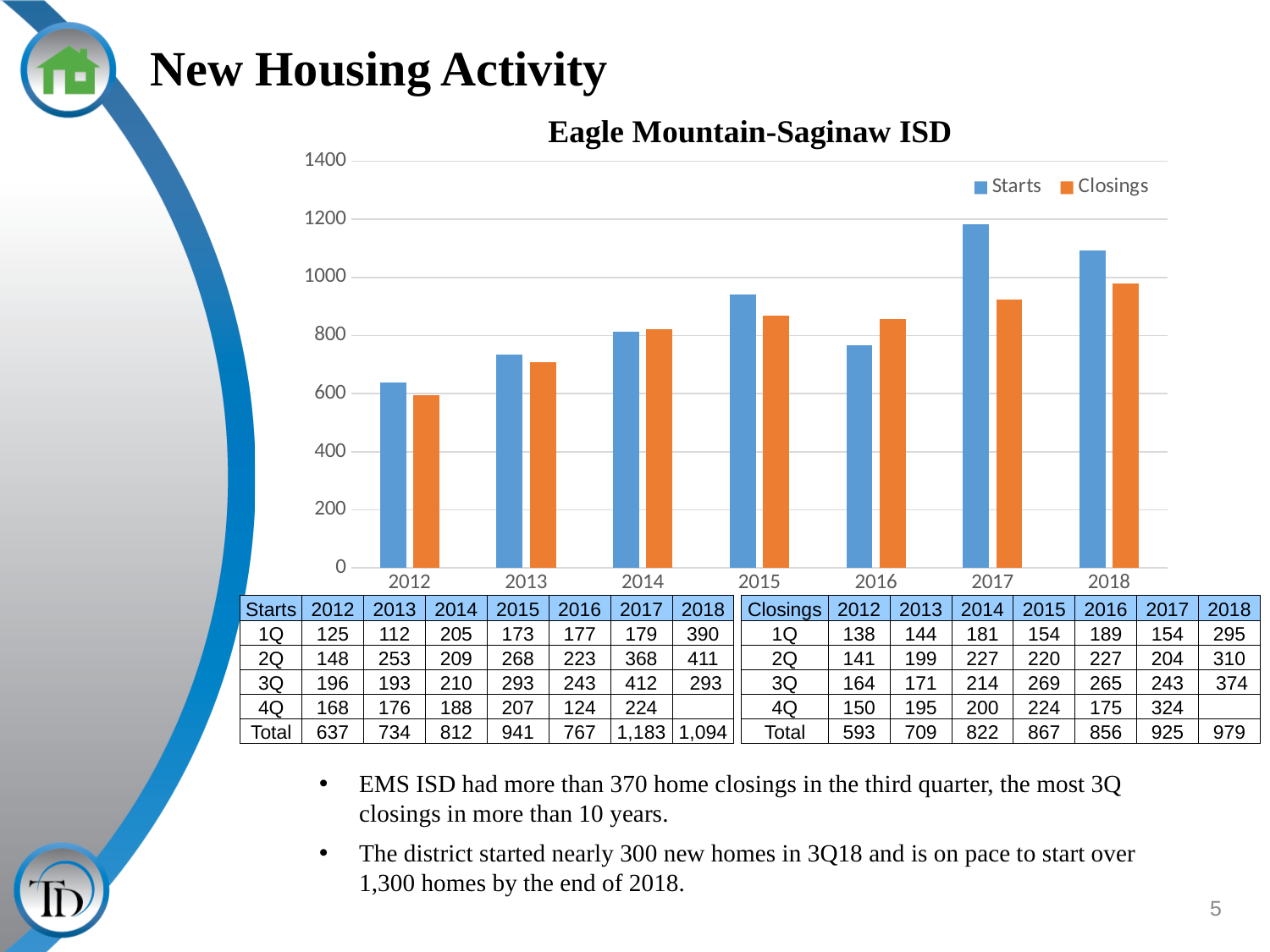
According to the table, what is the total Closings for 2018? 979 How many years are shown on the x axis of the chart? 7 How many series does the legend list? 2 Which year has the lowest Closings bar? 2012 What kind of chart is shown on the slide? bar chart In 2016, which is larger, Starts or Closings? Closings According to the table, what is the total Starts for 2017? 1,183 Which year has the highest Starts bar? 2017 Is the Closings value for 2012 greater or less than 600? less In 2017, which is larger, Starts or Closings? Starts Is the Starts value for 2017 greater or less than 1000? greater What is the title of the chart? Eagle Mountain-Saginaw ISD